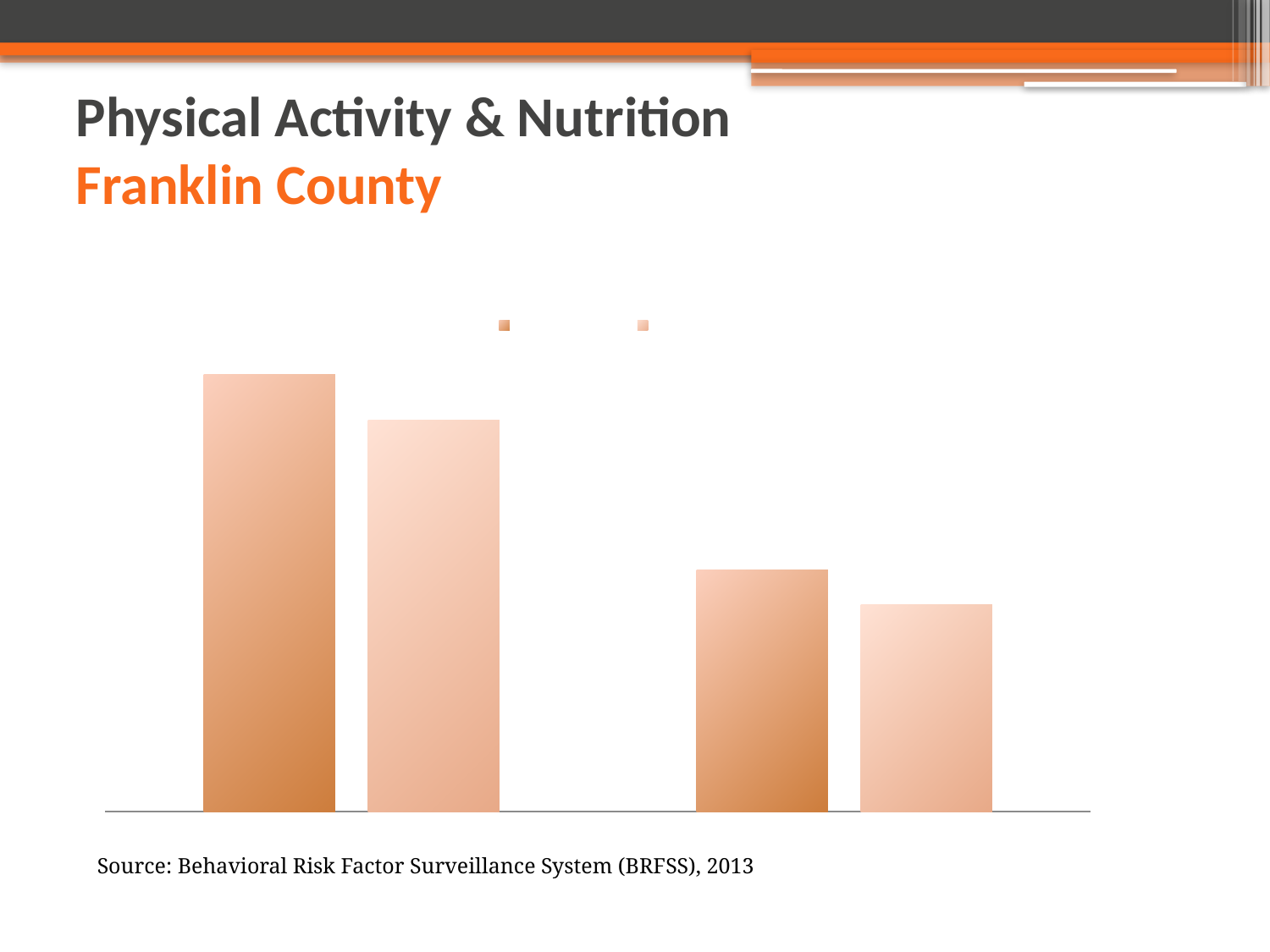
How many series does the chart's legend list? 2 Is the tallest bar in the chart in the left pair of bars or the right pair of bars? left pair Is the shortest bar in the chart in the left pair of bars or the right pair of bars? right pair Do the bar heights rise or fall from left to right across the chart? fall What kind of chart is shown on the slide? bar chart What data source is cited below the chart? Behavioral Risk Factor Surveillance System (BRFSS), 2013 How many bars are plotted in the chart? 4 Within each pair of bars, is the darker orange bar taller or shorter than the lighter bar next to it? taller